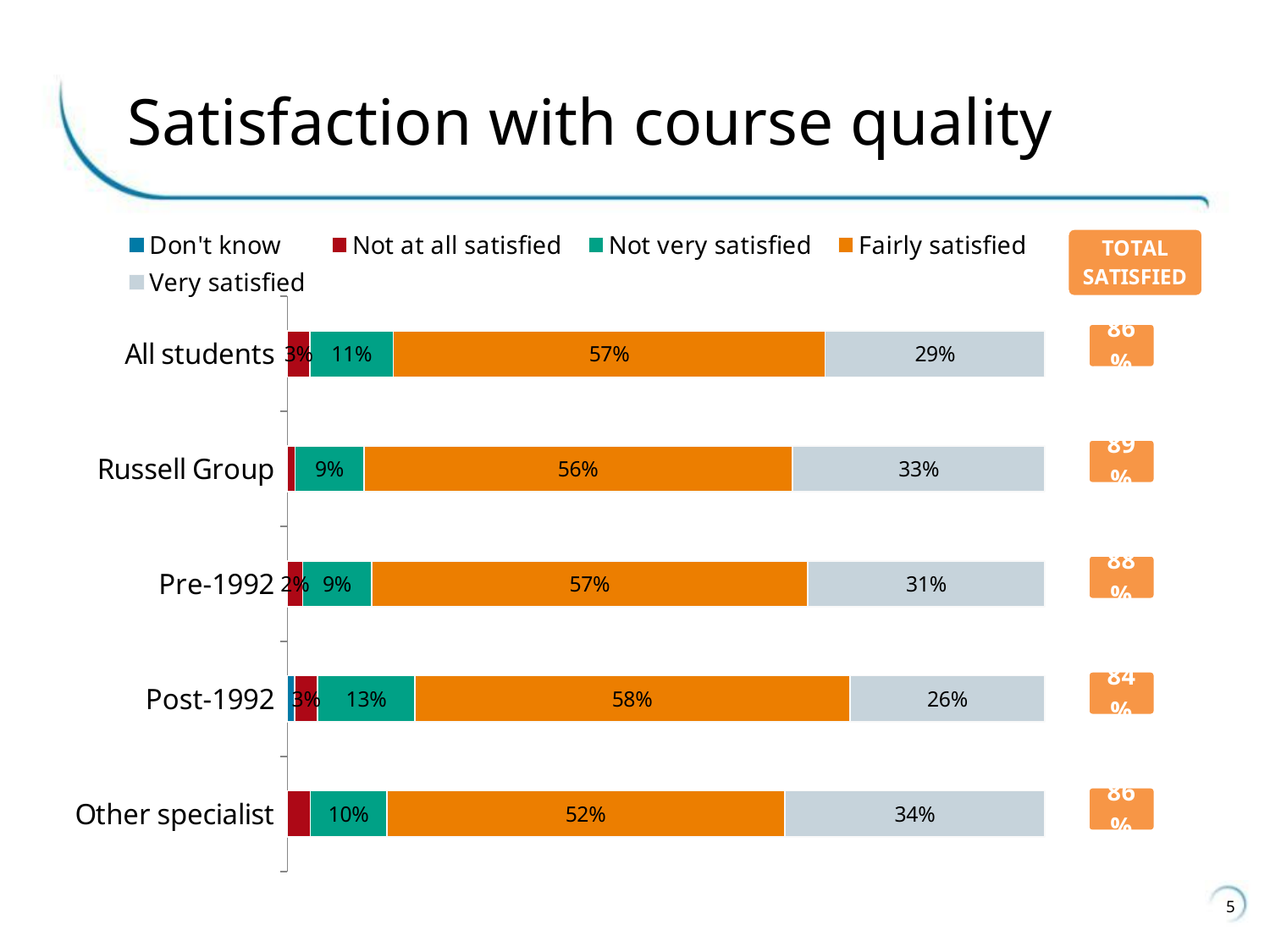
What percentage of Post-1992 students were Not very satisfied? 13% What percentage of All students were Fairly satisfied? 57% What percentage of Other specialist students were Fairly satisfied? 52% Which is larger: the Very satisfied percentage for Pre-1992 or for Post-1992? Pre-1992 How many series does the legend list? 5 Which category has the lowest Very satisfied percentage? Post-1992 Which category has the highest Very satisfied percentage? Other specialist What percentage of Russell Group students were Very satisfied? 33% What kind of chart is shown on the slide? Stacked bar chart How many categories are shown on the chart? 5 What is the difference in percentage points between the Fairly satisfied values for Post-1992 and Other specialist? 6 percentage points Which category has the highest Not very satisfied percentage? Post-1992